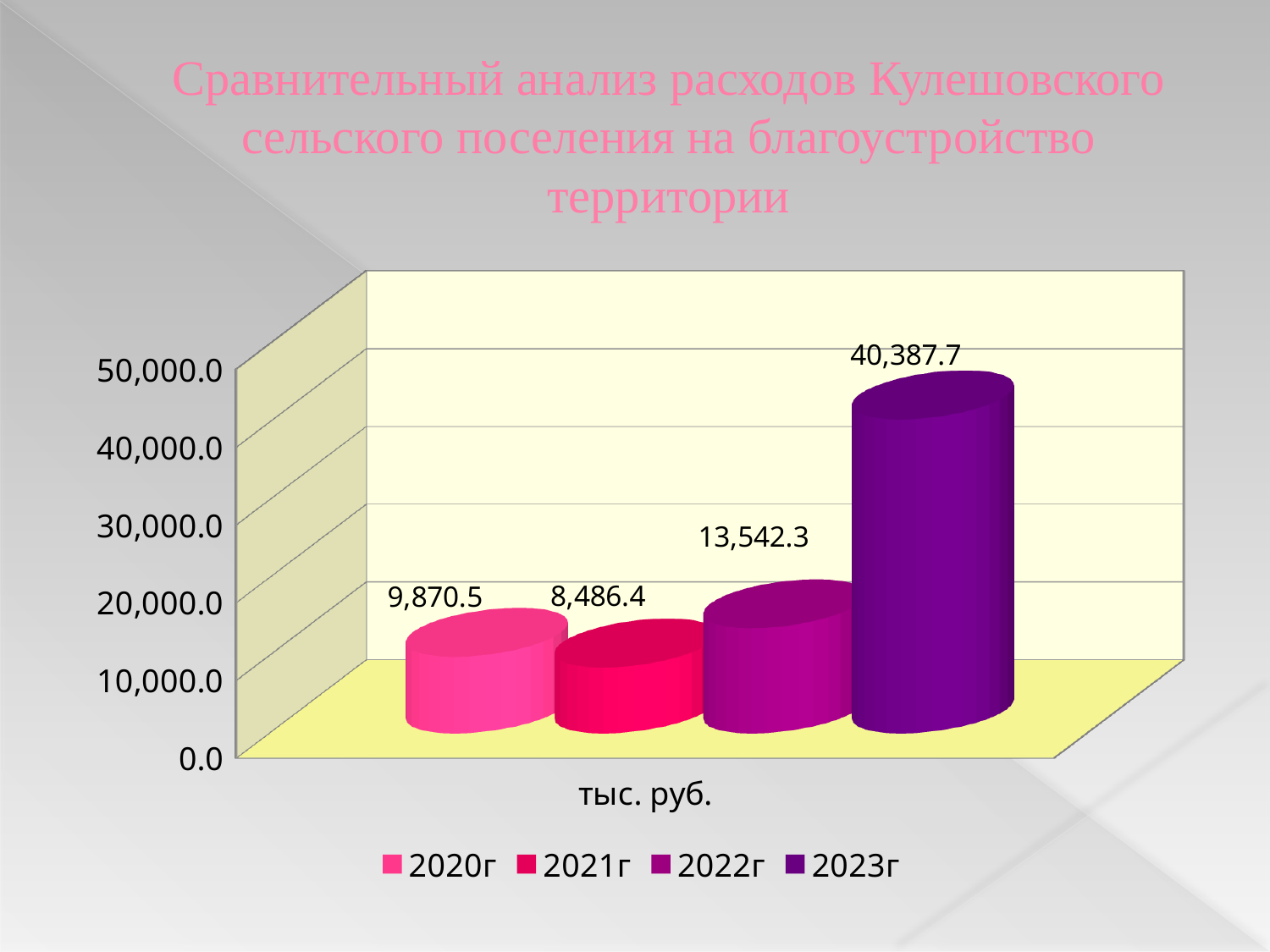
How many series does the legend list? 4 What is the difference between the values for 2023г and 2022г? 26,845.4 What is the value for 2020г? 9,870.5 Which is larger, the value for 2020г or the value for 2022г? 2022г What is the value for 2021г? 8,486.4 What is the value for 2022г? 13,542.3 What unit label is shown below the bars on the category axis? тыс. руб. Which year has the highest value? 2023г What kind of chart is shown on the slide? bar chart Which year has the lowest value? 2021г What is the value for 2023г? 40,387.7 What is the difference between the values for 2020г and 2021г? 1,384.1